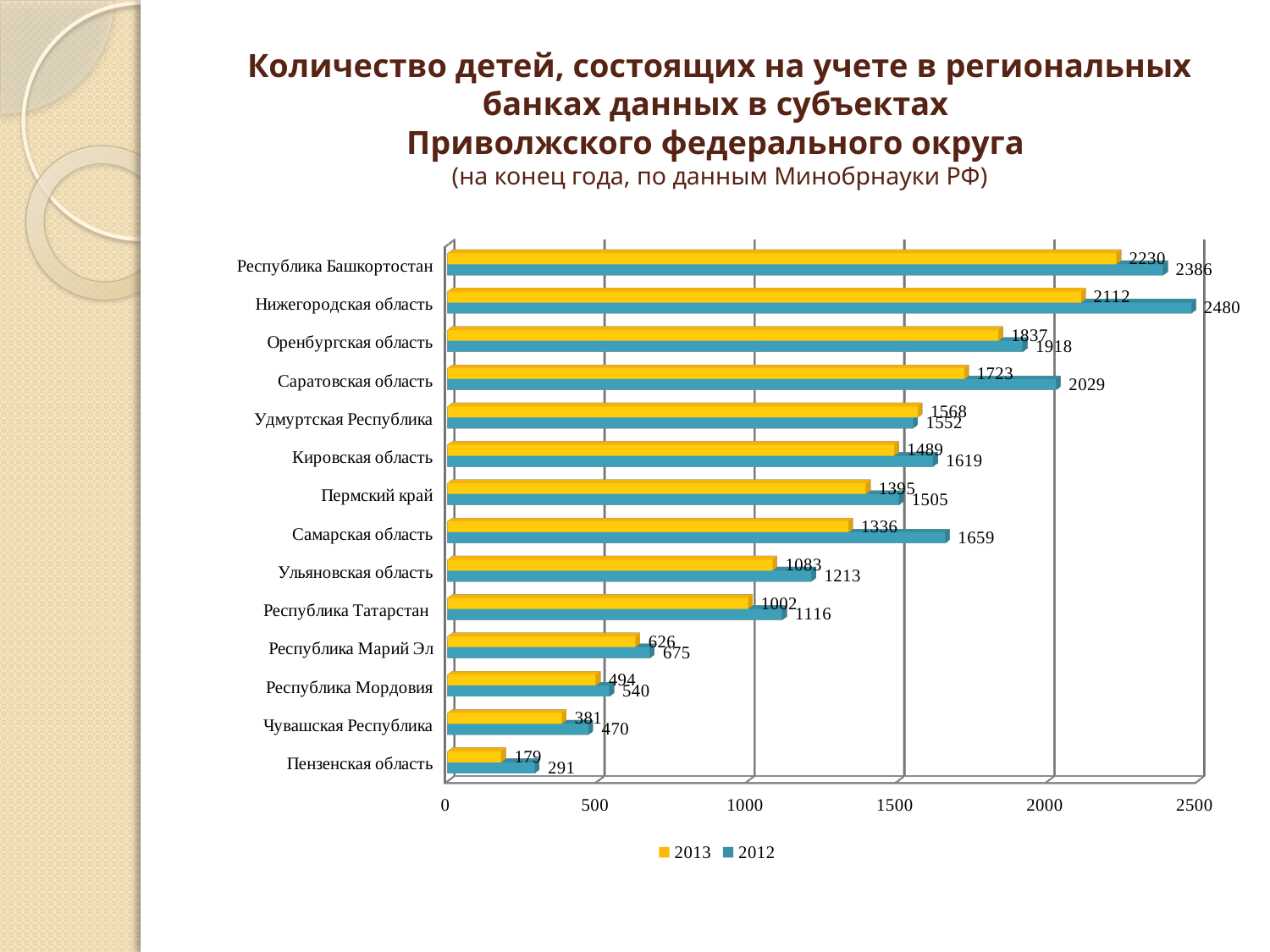
Which series is shown in yellow? 2013 What kind of chart is shown on the slide? Bar chart Which is larger for Удмуртская Республика: the 2013 value or the 2012 value? 2013 What is the 2012 value for Нижегородская область? 2480 What is the 2013 value for Самарская область? 1336 What is the 2012 value for Чувашская Республика? 470 Which region has the lowest 2013 value? Пензенская область What is the difference between the 2012 and 2013 values for Саратовская область? 306 How many regions are shown on the chart? 14 What is the 2013 value for Республика Башкортостан? 2230 Which region has the highest 2012 value? Нижегородская область How many series does the legend list? 2